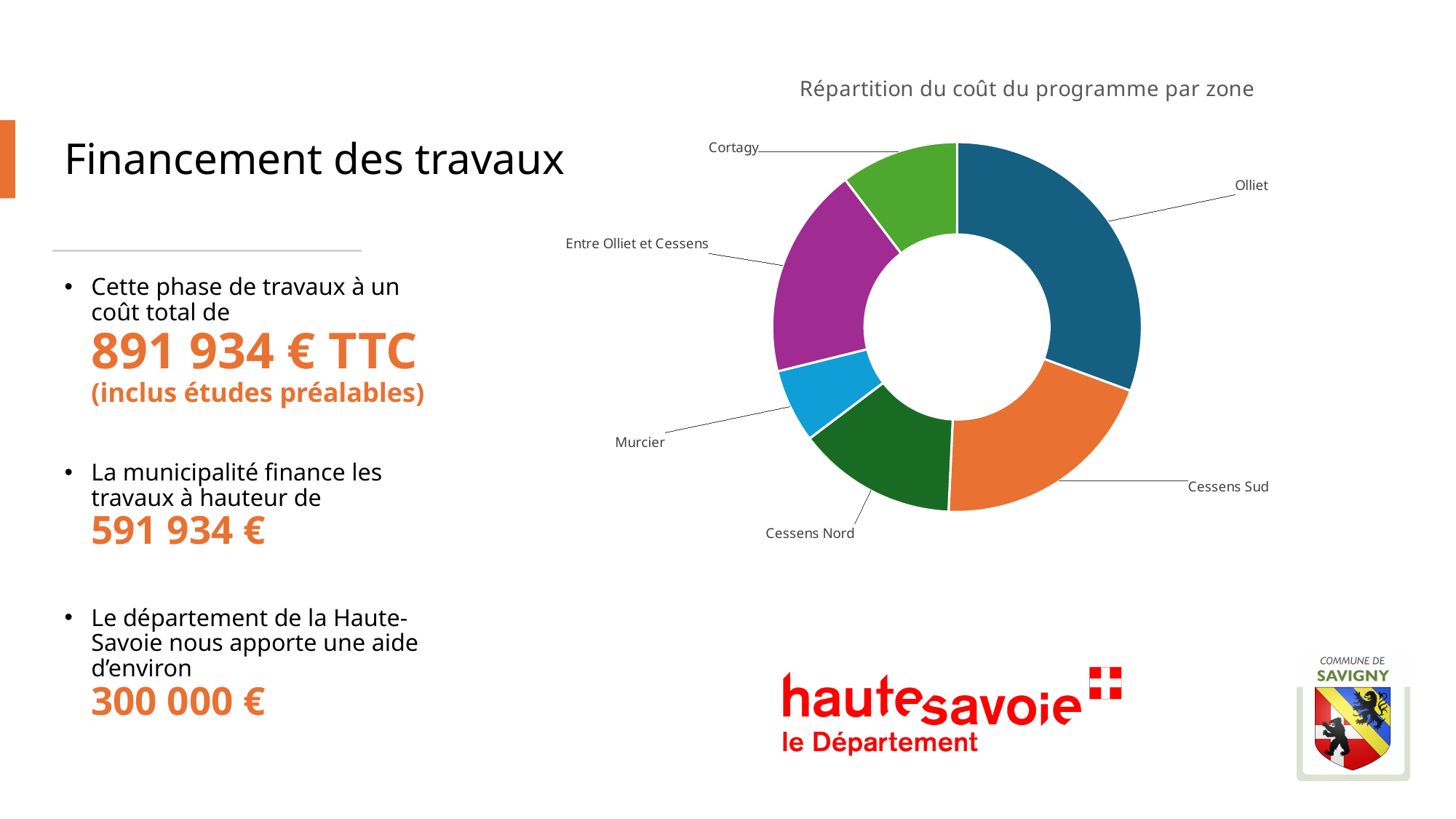
Which zone has the larger share, Cessens Sud or Cessens Nord? Cessens Sud Which zone has the larger share, Entre Olliet et Cessens or Cortagy? Entre Olliet et Cessens How many zones (slices) does the chart show? 6 Which zone has the smallest share of the programme cost? Murcier Which zone has the second-largest share of the programme cost? Cessens Sud Which zone has the larger share, Cessens Sud or Murcier? Cessens Sud What is the title of the chart? Répartition du coût du programme par zone What colour is the slice for Olliet? Dark blue Which zone has the largest share of the programme cost? Olliet What kind of chart is shown on the slide? Doughnut (pie) chart